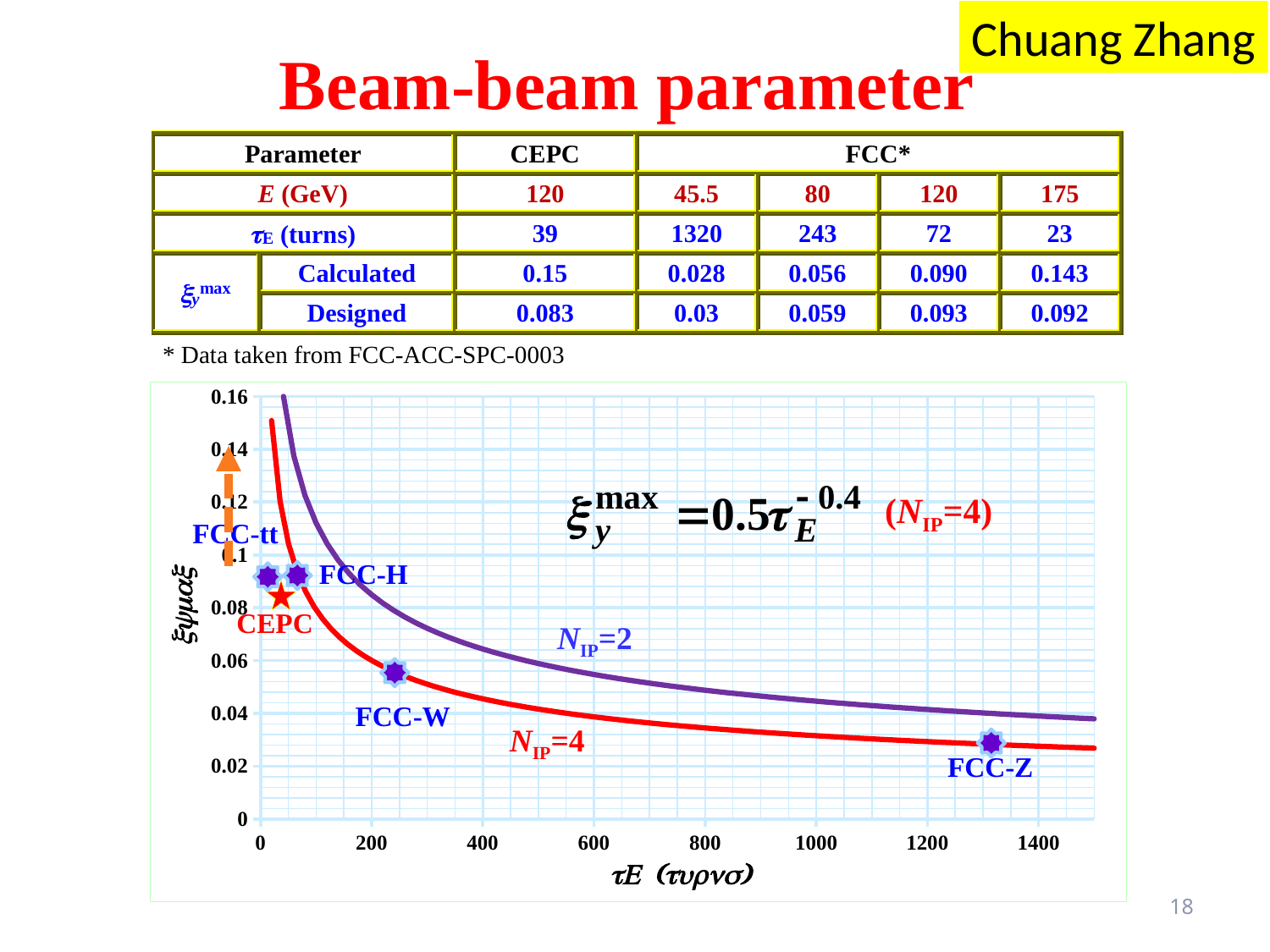
Is the ξy max value for FCC-H greater or less than 0.08? greater How many labeled data points (markers) are plotted on the chart? 5 Which curve lies higher on the chart, N_IP=2 or N_IP=4? N_IP=2 Which has the larger ξy max value on the chart, FCC-W or FCC-Z? FCC-W Which labeled point on the chart has the lowest ξy max value? FCC-Z Is the τE value for FCC-Z greater or less than 1200? greater Is the ξy max value for FCC-W greater or less than 0.04? greater Do the plotted curves rise or fall as τE increases along the x axis? fall What is the highest tick value shown on the y axis of the chart? 0.16 Which labeled point on the chart has the largest τE value? FCC-Z What kind of chart is shown on the slide? line chart